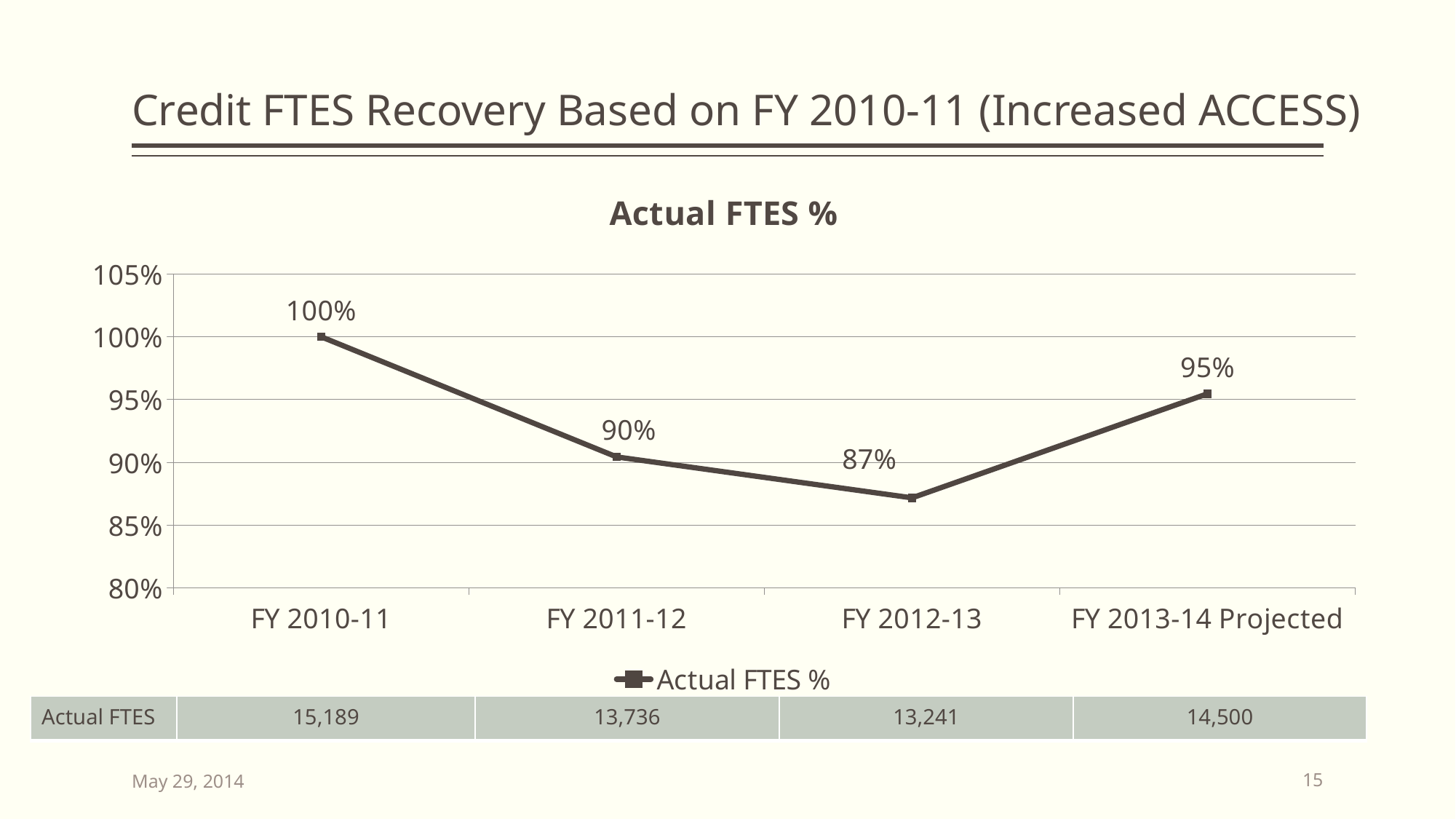
What is the Actual FTES % for FY 2012-13? 87% What is the difference in Actual FTES % between FY 2010-11 and FY 2012-13? 13% Which fiscal year has the lowest Actual FTES %? FY 2012-13 How many series does the legend list? 1 Which fiscal year has the highest Actual FTES %? FY 2010-11 Which is larger, the Actual FTES % for FY 2011-12 or for FY 2013-14 Projected? FY 2013-14 Projected What kind of chart is shown on the slide? Line chart What is the Actual FTES % for FY 2013-14 Projected? 95% Does the Actual FTES % rise or fall from FY 2010-11 to FY 2012-13? Fall What is the Actual FTES % for FY 2010-11? 100% What is the title of the chart? Actual FTES % How many fiscal years are plotted on the chart? 4